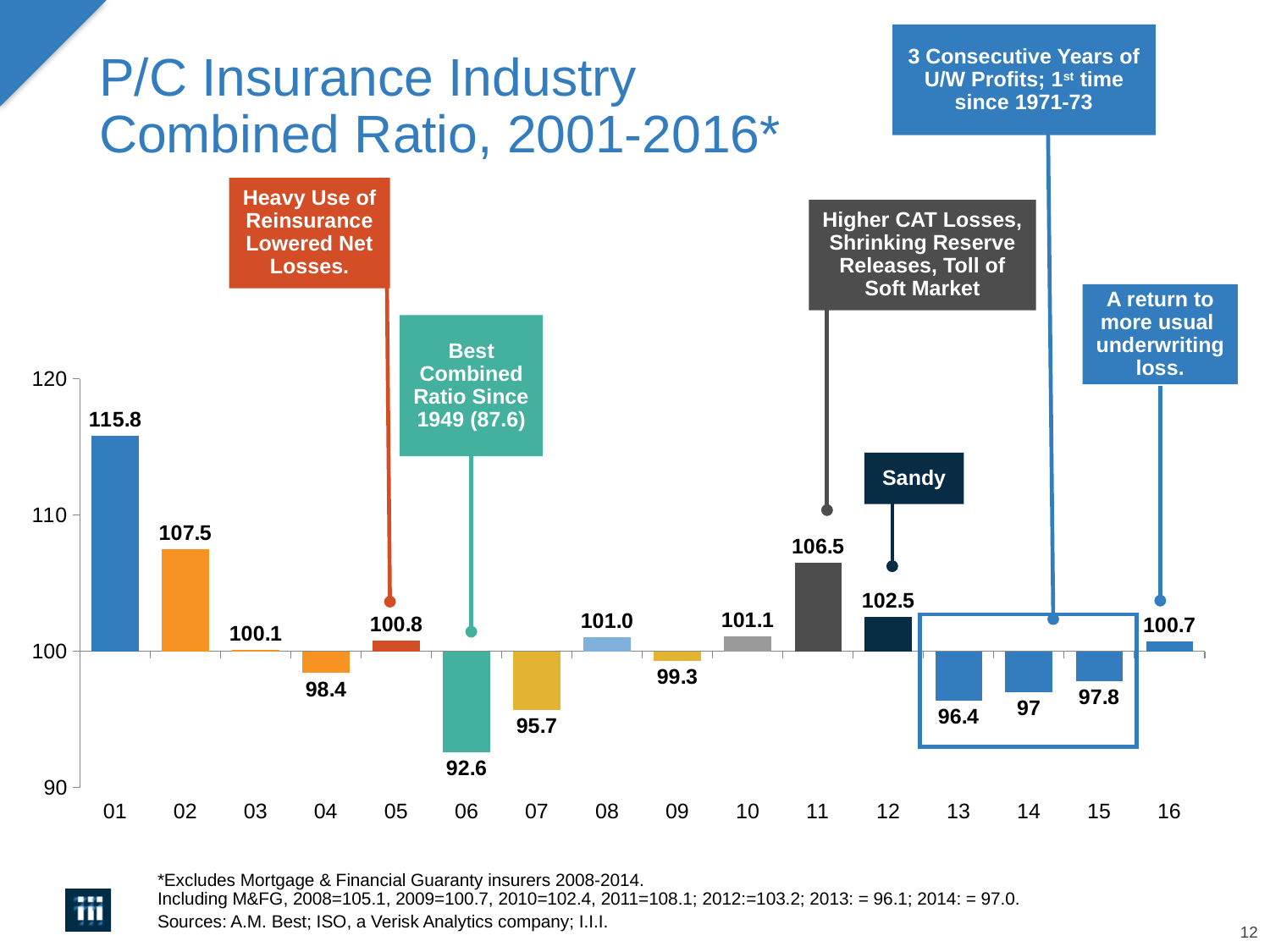
How many years are shown on the x axis? 16 What is the combined ratio for 2006? 92.6 What is the combined ratio for 2001? 115.8 Is the value for 2007 greater or less than 100? less Which year has the lowest combined ratio? 06 What does the callout above the 2012 bar say? Sandy What kind of chart is shown on the slide? bar chart What is the combined ratio for 2016? 100.7 Which year has the highest combined ratio? 01 What is the difference between the combined ratio in 2001 and in 2002? 8.3 What is the combined ratio for 2012? 102.5 Which is larger, the combined ratio for 2011 or for 2012? 2011